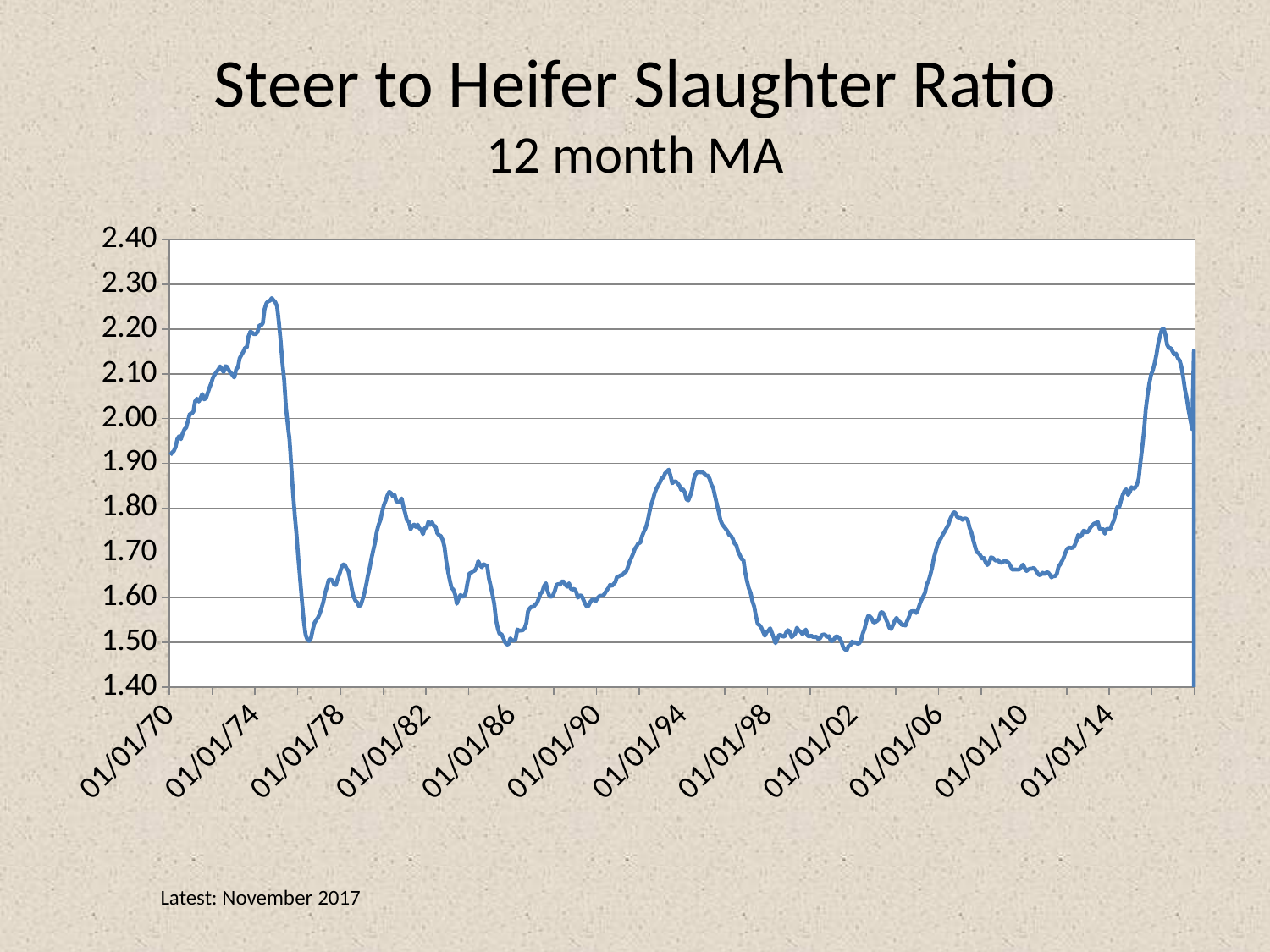
Is the value at 01/01/94 greater or less than 1.70? greater Is the value at 01/01/14 greater or less than 1.60? greater Is the value at 01/01/98 greater or less than 1.70? less According to the note at the bottom of the slide, what is the latest month of data shown? November 2017 Does the ratio rise or fall between 01/01/10 and 01/01/14? rise What is the title of the chart on the slide? Steer to Heifer Slaughter Ratio Does the ratio rise or fall between 01/01/70 and 01/01/74? rise What kind of chart is shown on the slide? line chart